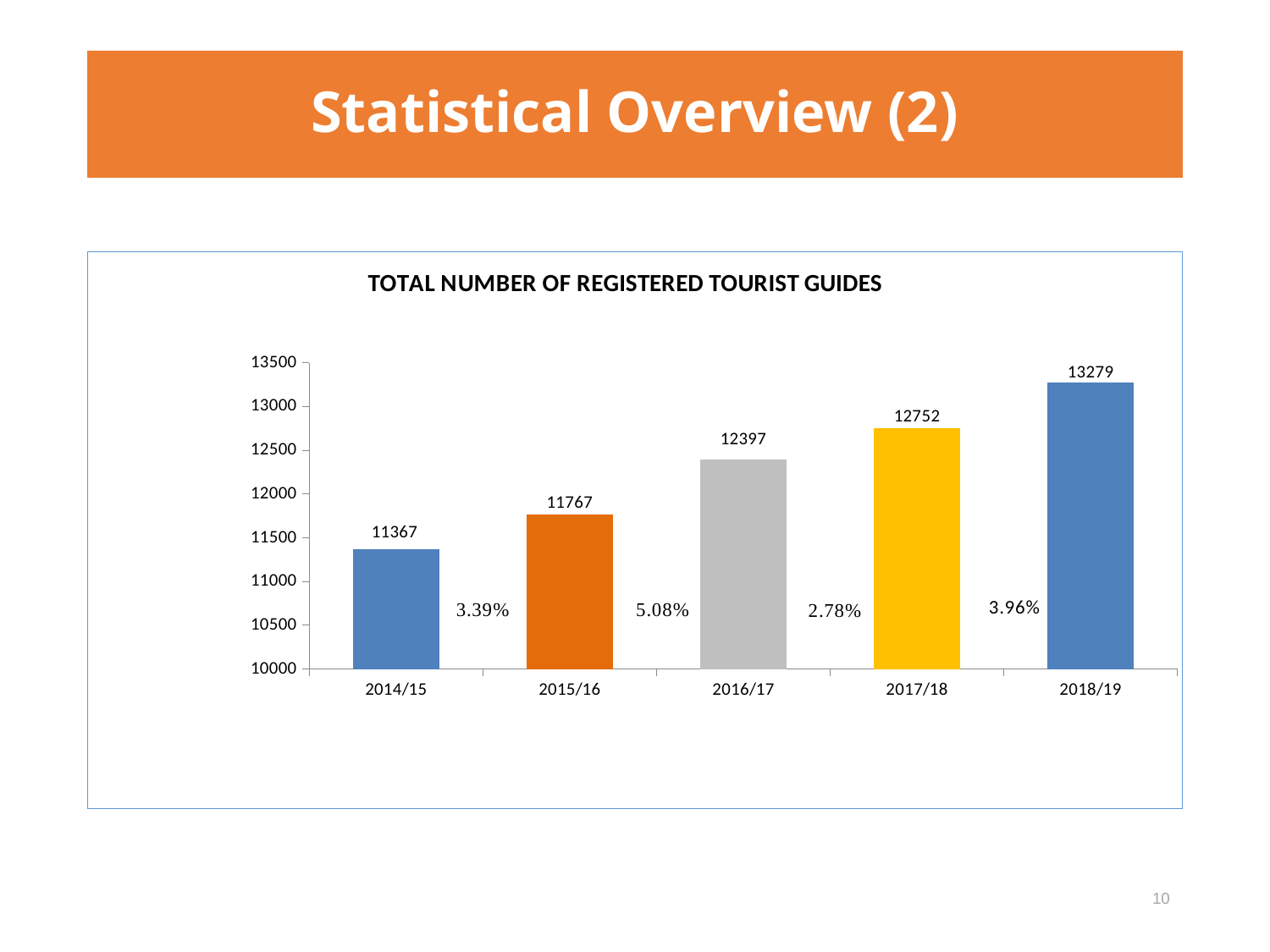
Is the value for 2015/16 greater or less than 12000? less What is the difference between the number of registered tourist guides in 2018/19 and 2014/15? 1912 What is the difference between the number of registered tourist guides in 2017/18 and 2016/17? 355 What is the total number of registered tourist guides in 2016/17? 12397 Which year has the lowest number of registered tourist guides? 2014/15 How many years are shown on the chart? 5 What is the total number of registered tourist guides in 2018/19? 13279 What kind of chart is shown on the slide? Bar chart Do the values rise or fall from 2014/15 to 2018/19? Rise What is the total number of registered tourist guides in 2014/15? 11367 Which year has more registered tourist guides, 2015/16 or 2017/18? 2017/18 Which year has the highest number of registered tourist guides? 2018/19